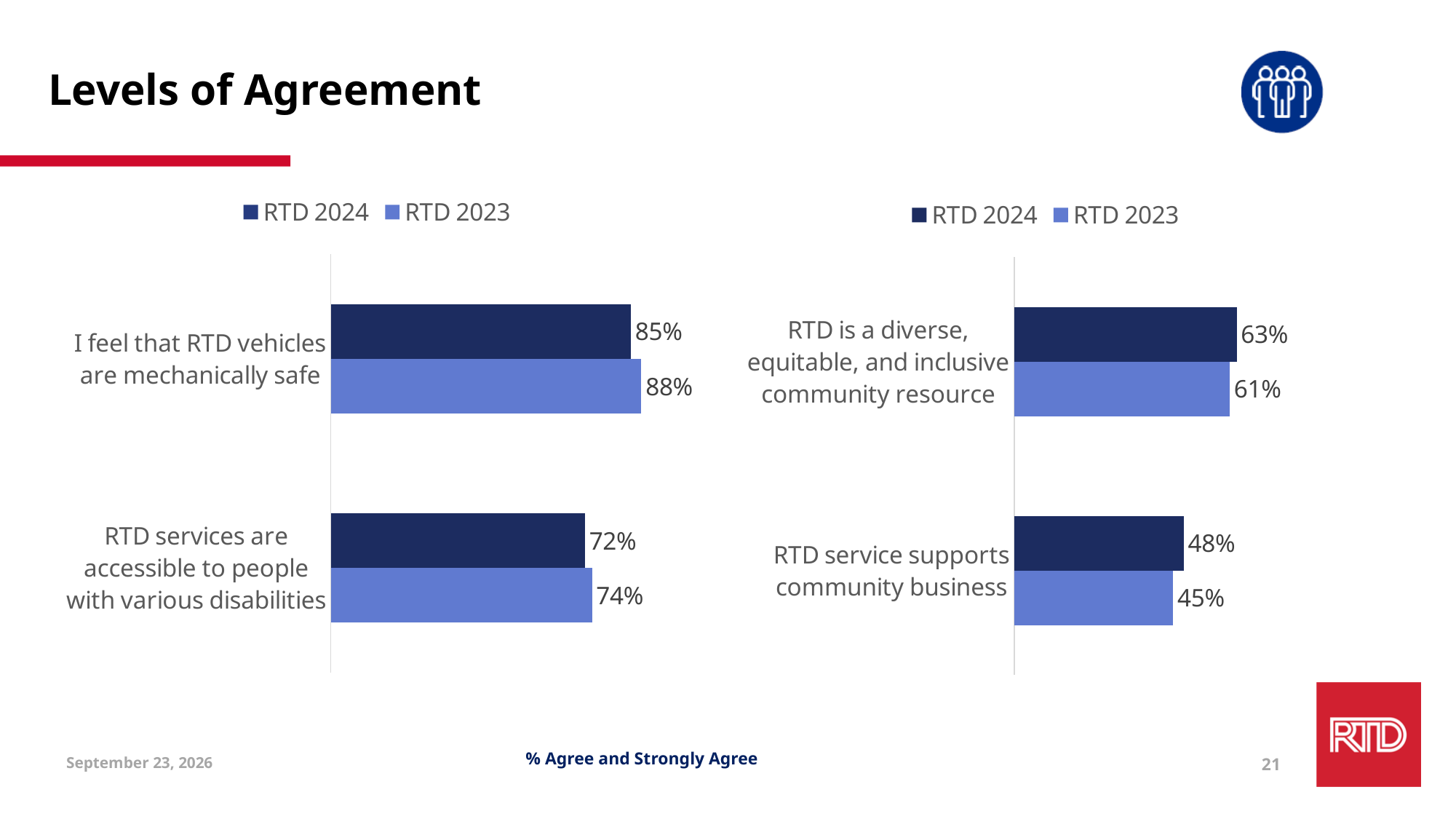
In the left chart, what is the RTD 2024 value for "I feel that RTD vehicles are mechanically safe"? 85% In the left chart, what is the difference between the RTD 2023 and RTD 2024 values for "I feel that RTD vehicles are mechanically safe"? 3% In the right chart, what is the difference between the RTD 2024 and RTD 2023 values for "RTD service supports community business"? 3% In the left chart, what is the RTD 2023 value for "RTD services are accessible to people with various disabilities"? 74% In the right chart, which category has the highest RTD 2023 value? RTD is a diverse, equitable, and inclusive community resource In the left chart, which category has the lowest RTD 2024 value? RTD services are accessible to people with various disabilities How many series does the legend of the left chart list? 2 How many categories are shown in the right chart? 2 In the right chart, which is larger for "RTD is a diverse, equitable, and inclusive community resource": RTD 2024 or RTD 2023? RTD 2024 In the right chart, what is the RTD 2024 value for "RTD is a diverse, equitable, and inclusive community resource"? 63% In the right chart, what is the RTD 2023 value for "RTD service supports community business"? 45% What kind of chart is the left chart? Bar chart